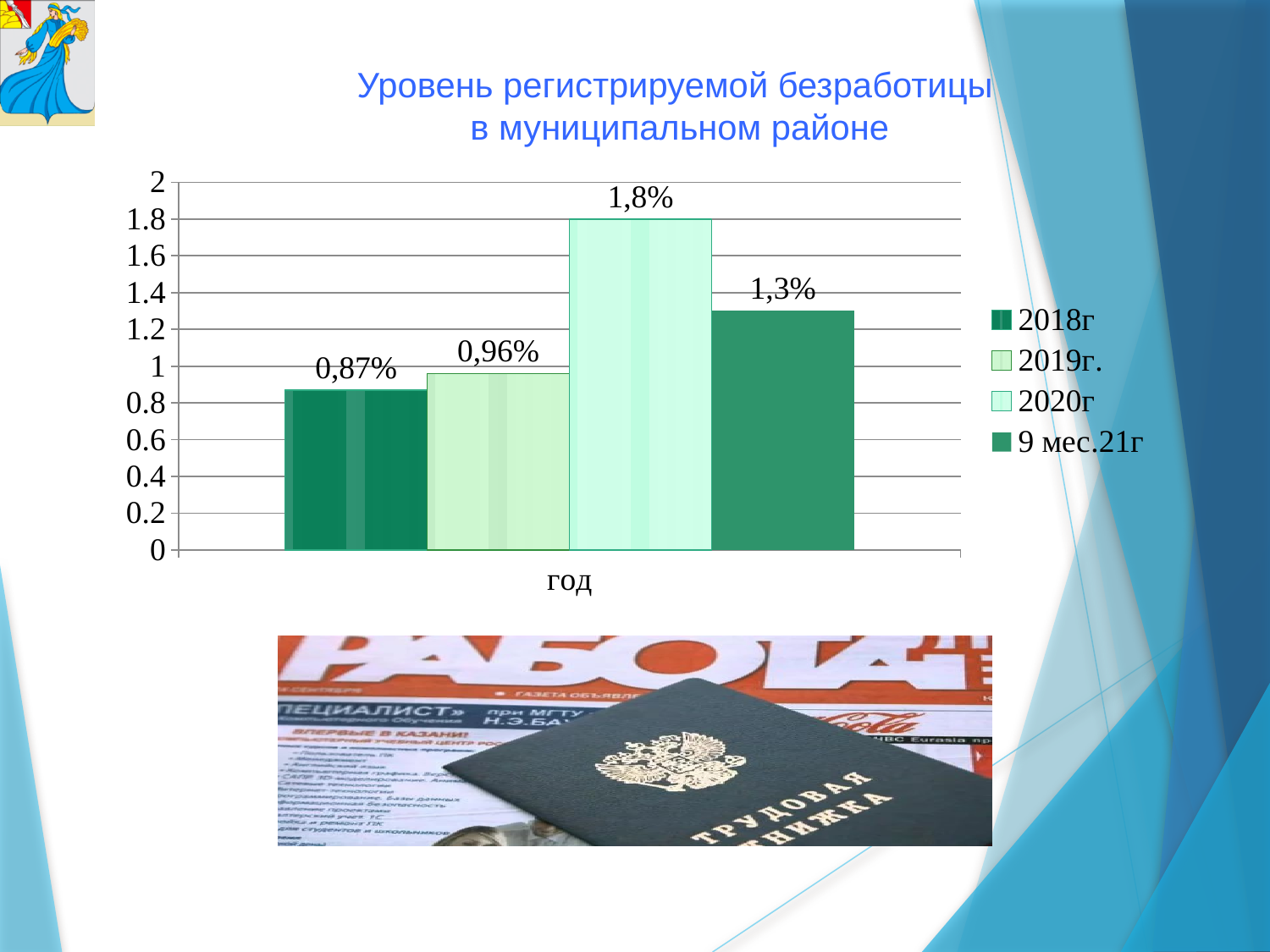
How many entries does the legend list? 4 What value is labelled on the bar for 2019г.? 0,96% Is the value for 2019г. greater or less than 1? less How many bars are plotted on the chart? 4 What is the value shown for 9 мес.21г? 1,3% Which period has the lowest registered unemployment rate? 2018г What kind of chart is shown on the slide? bar chart What is the registered unemployment rate shown for 2018г? 0,87% Which period has the highest registered unemployment rate? 2020г Which is larger, the value for 2020г or the value for 9 мес.21г? 2020г What is the value shown for 2020г? 1,8% What is the label on the horizontal axis of the chart? год